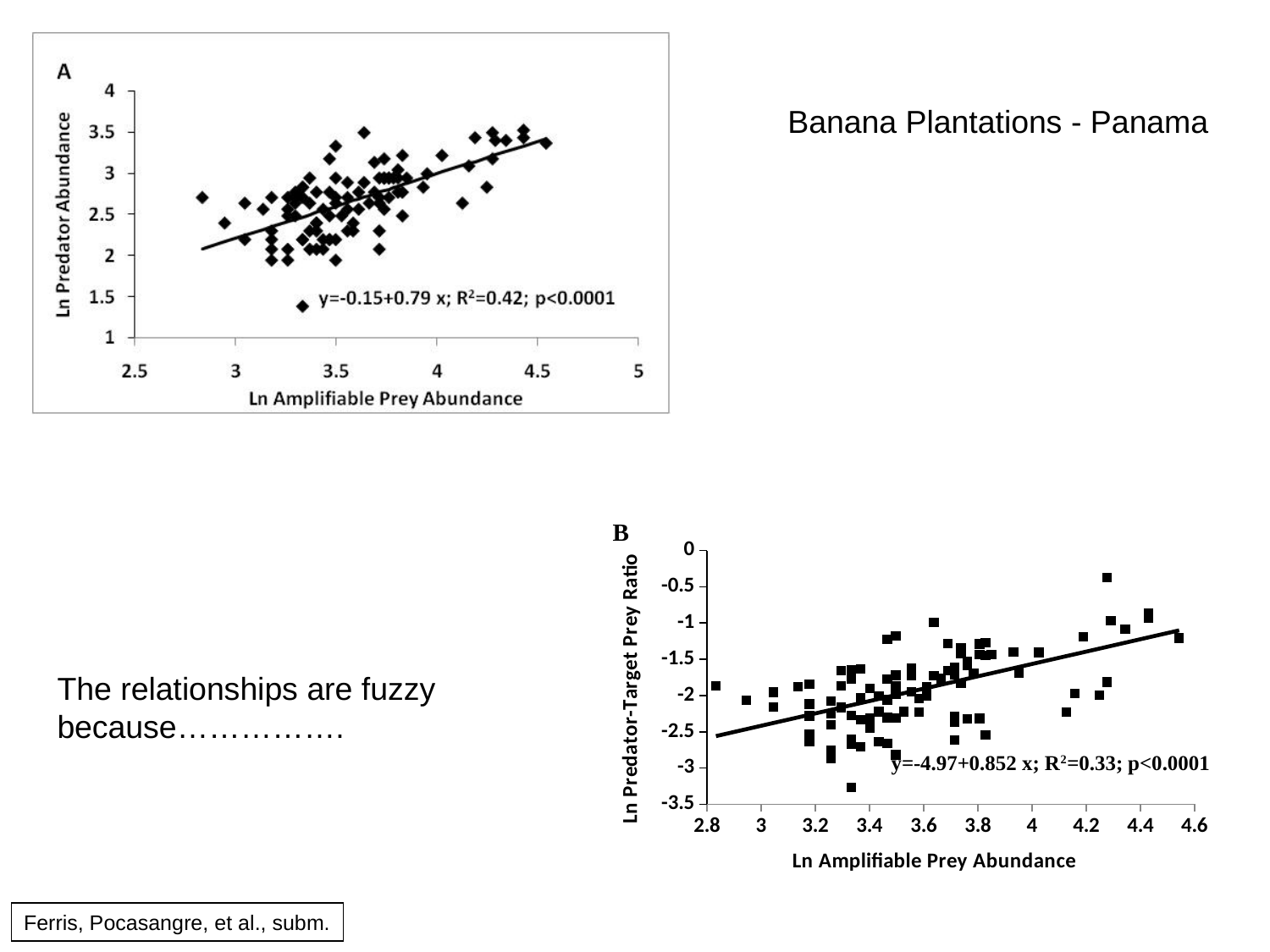
In chart B, does Ln Predator-Target Prey Ratio tend to rise or fall as Ln Amplifiable Prey Abundance increases? rise What kind of chart is chart B (bottom right)? scatter plot Which chart reports the higher R² value, chart A or chart B? chart A In chart B, what is the intercept of the fitted regression line shown in the equation? -4.97 What is the y-axis label of chart B? Ln Predator-Target Prey Ratio In chart A, what is the slope of the fitted regression line shown in the equation? 0.79 In chart A, what is the R² value printed for the regression? 0.42 What kind of chart is chart A (top left)? scatter plot In chart A, does Ln Predator Abundance tend to rise or fall as Ln Amplifiable Prey Abundance increases? rise In chart B, what is the R² value printed for the regression? 0.33 How many charts are shown on the slide? 2 In chart B, is the lowest plotted point's y value greater or less than -3? less